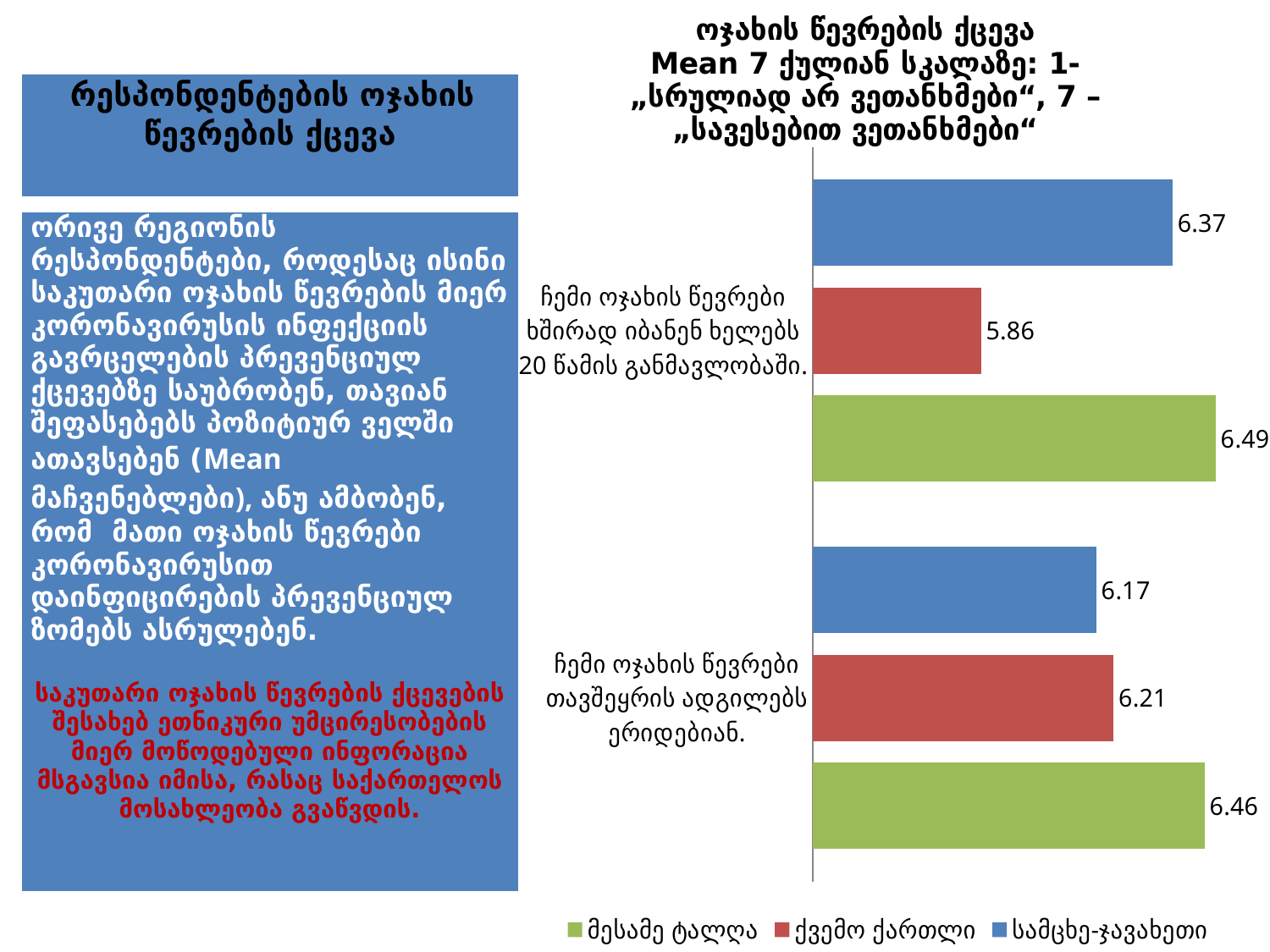
What is the value for ქვემო ქართლი in the category "ჩემი ოჯახის წევრები თავშეყრის ადგილებს ერიდებიან."? 6.21 What colour are the bars for the series ქვემო ქართლი? red Which series has the highest value in the category "ჩემი ოჯახის წევრები ხშირად იბანენ ხელებს 20 წამის განმავლობაში."? მესამე ტალღა How many series does the chart legend list? 3 What is the value for სამცხე-ჯავახეთი in the category "ჩემი ოჯახის წევრები ხშირად იბანენ ხელებს 20 წამის განმავლობაში."? 6.37 Which is larger: the სამცხე-ჯავახეთი value for "ჩემი ოჯახის წევრები ხშირად იბანენ ხელებს 20 წამის განმავლობაში." or for "ჩემი ოჯახის წევრები თავშეყრის ადგილებს ერიდებიან."? ჩემი ოჯახის წევრები ხშირად იბანენ ხელებს 20 წამის განმავლობაში. How many categories are shown on the chart? 2 Which series has the lowest value in the category "ჩემი ოჯახის წევრები თავშეყრის ადგილებს ერიდებიან."? სამცხე-ჯავახეთი What is the value for მესამე ტალღა in the category "ჩემი ოჯახის წევრები თავშეყრის ადგილებს ერიდებიან."? 6.46 What is the difference between the მესამე ტალღა and ქვემო ქართლი values in the category "ჩემი ოჯახის წევრები ხშირად იბანენ ხელებს 20 წამის განმავლობაში."? 0.63 What is the value for ქვემო ქართლი in the category "ჩემი ოჯახის წევრები ხშირად იბანენ ხელებს 20 წამის განმავლობაში."? 5.86 What type of chart is shown on the slide? bar chart